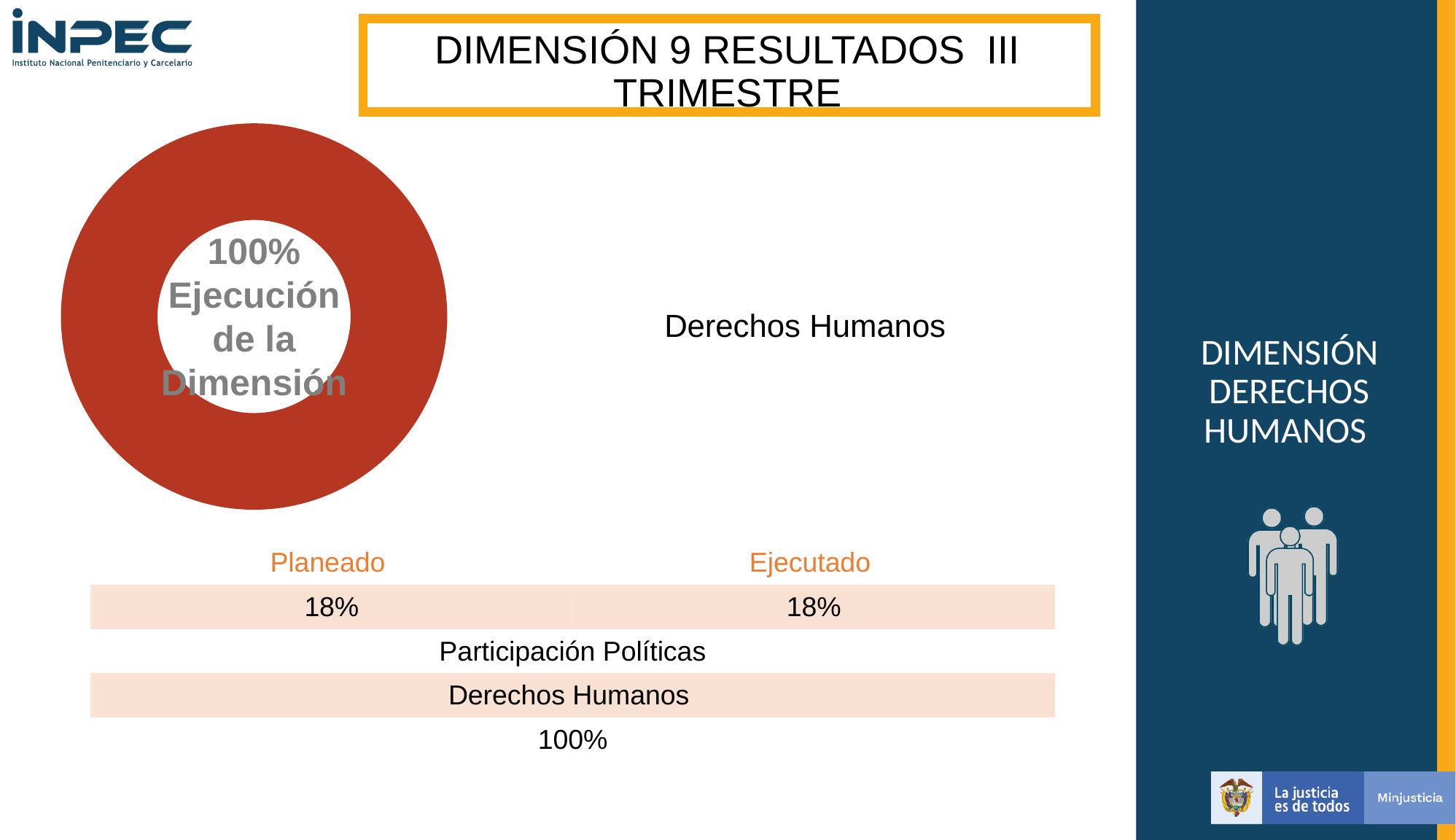
In the table below the chart, what value is shown for Derechos Humanos? 100% What kind of chart is shown on the left of the slide? Doughnut chart In the table below the chart, what is the Ejecutado value for Participación Políticas? 18% In the table below the chart, what is the difference between the Planeado and Ejecutado values for Participación Políticas? 0% What colour is the slice of the doughnut chart? Red What percentage is printed in the centre of the doughnut chart? 100% In the table below the chart, what is the Planeado value for Participación Políticas? 18% How many slices does the doughnut chart have? 1 Is the value shown in the doughnut chart greater or less than 50%? greater What share of the doughnut chart does the single slice occupy? 100% What is the title of the slide containing the doughnut chart? DIMENSIÓN 9 RESULTADOS III TRIMESTRE What text accompanies the percentage in the centre of the doughnut chart? Ejecución de la Dimensión